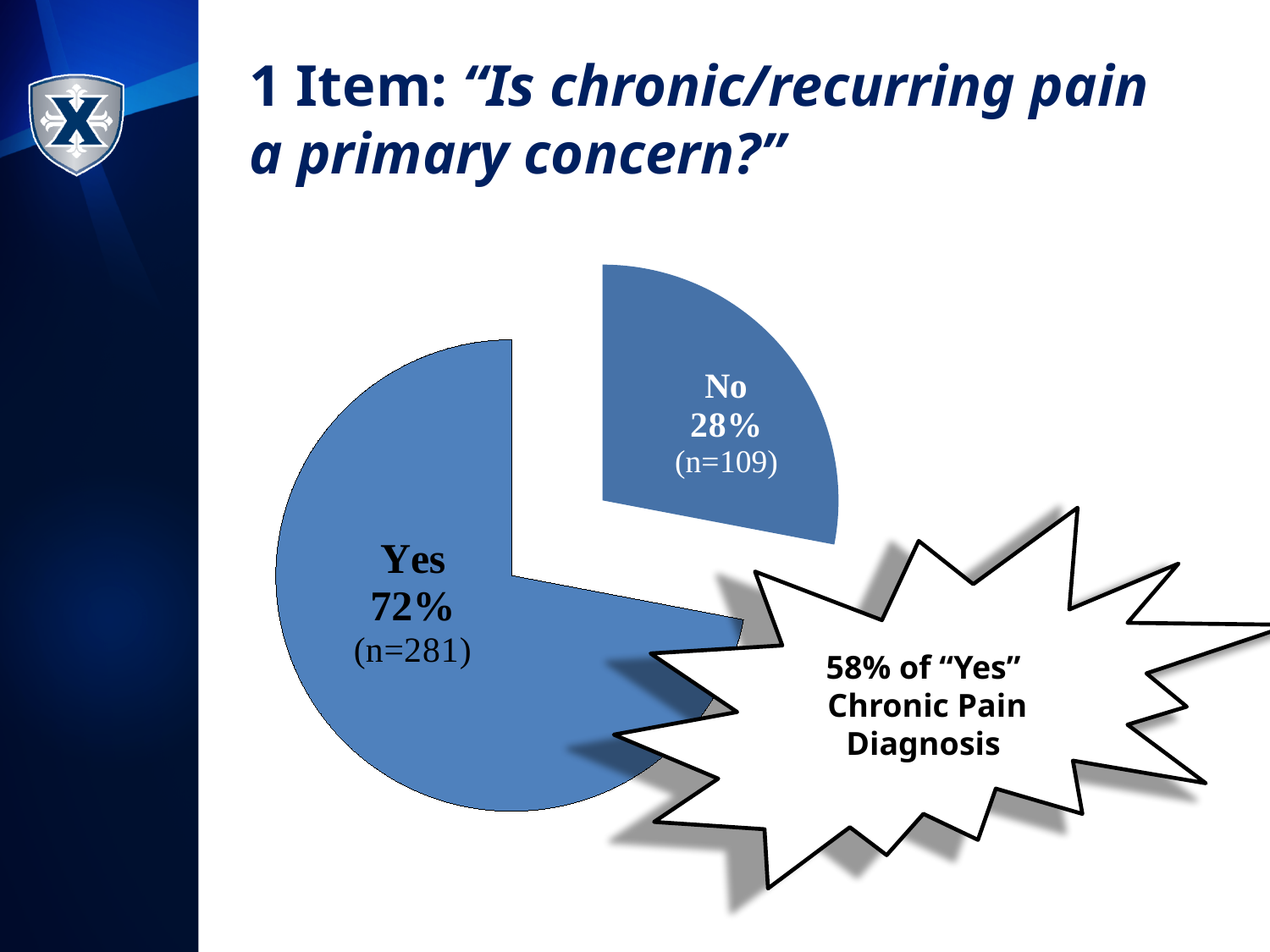
What percentage of respondents answered "Yes"? 72% How many respondents answered "No"? 109 What kind of chart is shown on the slide? pie chart Which slice of the pie is the largest? Yes What percentage of respondents answered "No"? 28% Which is larger, the "Yes" slice or the "No" slice? Yes What is the difference in the number of respondents between "Yes" and "No"? 172 What share of the pie does the "No" slice represent? 28% Which slice of the pie is the smallest? No How many respondents answered "Yes"? 281 What is the difference in percentage points between the "Yes" and "No" slices? 44 How many slices does the pie chart have? 2